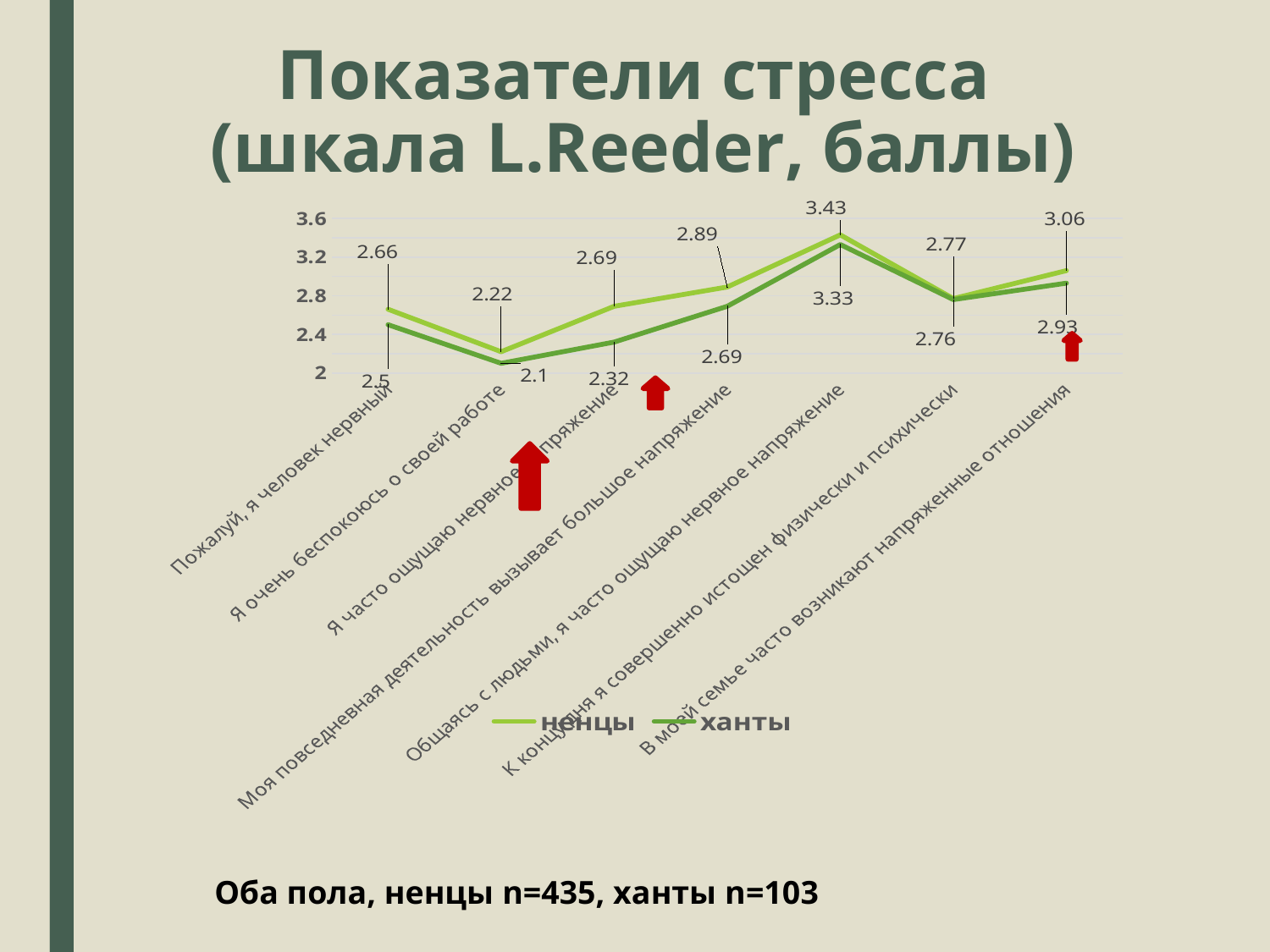
What is the value for ханты for "Я очень беспокоюсь о своей работе"? 2.1 What is the value for ханты for "В моей семье часто возникают напряженные отношения"? 2.93 For which category is the ненцы value highest? Общаясь с людьми, я часто ощущаю нервное напряжение What kind of chart is shown on the slide? line chart How many categories are plotted along the x axis? 7 Which series has the larger value for "Моя повседневная деятельность вызывает большое напряжение", ненцы or ханты? ненцы What is the title of the chart on the slide? Показатели стресса (шкала L.Reeder, баллы) What is the difference between the ненцы and ханты values for "Я часто ощущаю нервное напряжение"? 0.37 For which category is the ханты value lowest? Я очень беспокоюсь о своей работе What is the value for ненцы for "Пожалуй, я человек нервный"? 2.66 How many series does the legend list? 2 What is the value for ненцы for "Общаясь с людьми, я часто ощущаю нервное напряжение"? 3.43